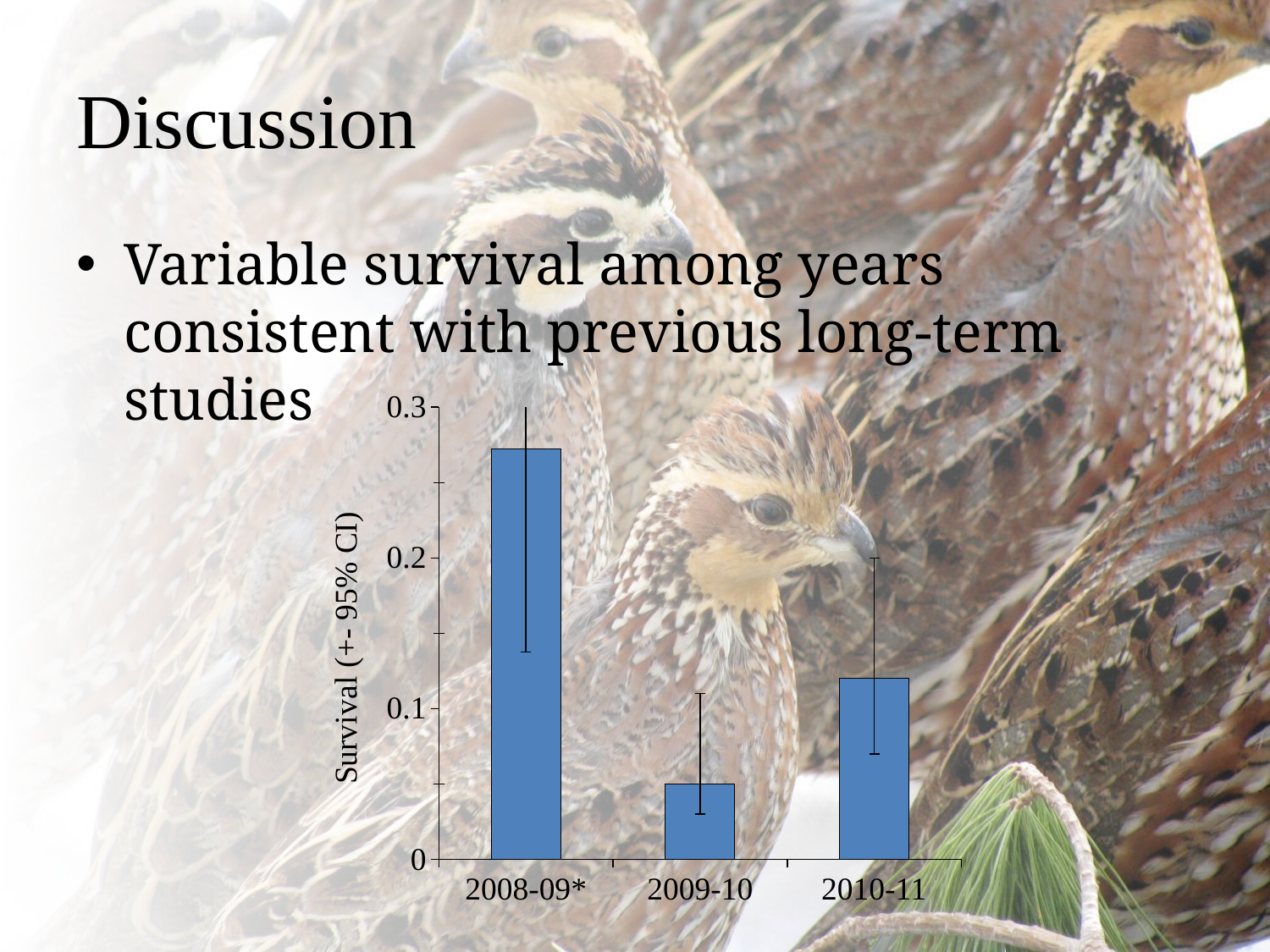
Which year has the highest survival value in the chart? 2008-09* Is the survival value for 2009-10 greater or less than 0.1? less Does the survival value rise or fall from 2008-09* to 2009-10? fall Is the survival value for 2010-11 greater or less than 0.2? less Which has the larger survival value, 2008-09* or 2010-11? 2008-09* Which has the larger survival value, 2009-10 or 2010-11? 2010-11 What is the highest tick value shown on the y axis of the chart? 0.3 What is the label on the y axis of the chart? Survival (+- 95% CI) How many categories (years) are plotted on the x axis of the chart? 3 What kind of chart is shown on the slide? bar chart Which year has the lowest survival value in the chart? 2009-10 Is the survival value for 2008-09* greater or less than 0.2? greater